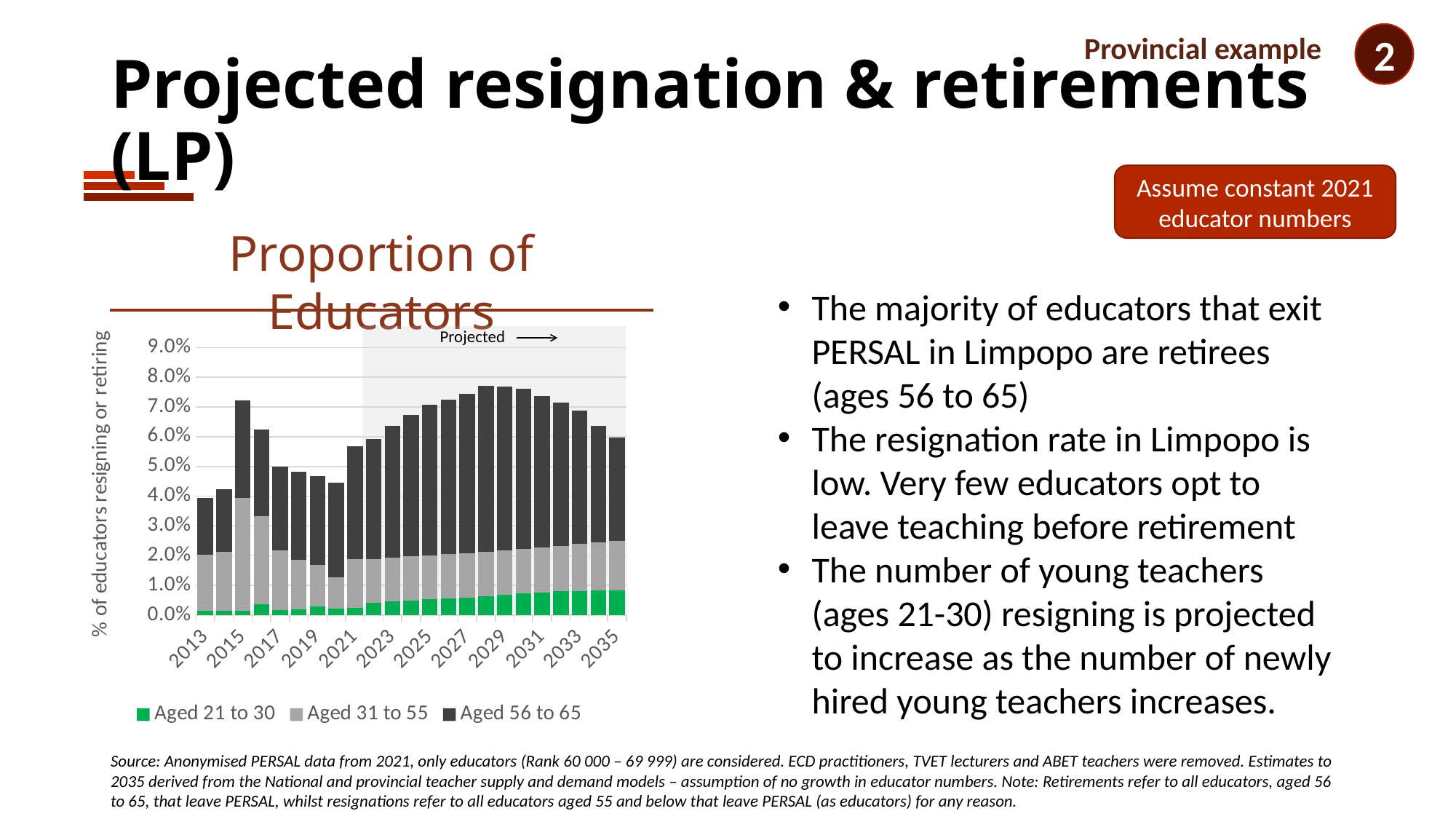
Which age group is shown in green in the chart? Aged 21 to 30 Is the total value for 2029 greater or less than 7.0%? greater Is the total value for 2013 greater or less than 5.0%? less Which year has the larger total bar, 2013 or 2015? 2015 Is the total value for 2021 greater or less than 5.0%? greater How many years (bars) are plotted in the chart? 23 Do the total bar values rise or fall from 2029 to 2035? fall What kind of chart is shown on the slide? Stacked bar chart Which year has the larger total bar, 2021 or 2029? 2029 What is the label on the vertical axis of the chart? % of educators resigning or retiring How many series does the chart legend list? 3